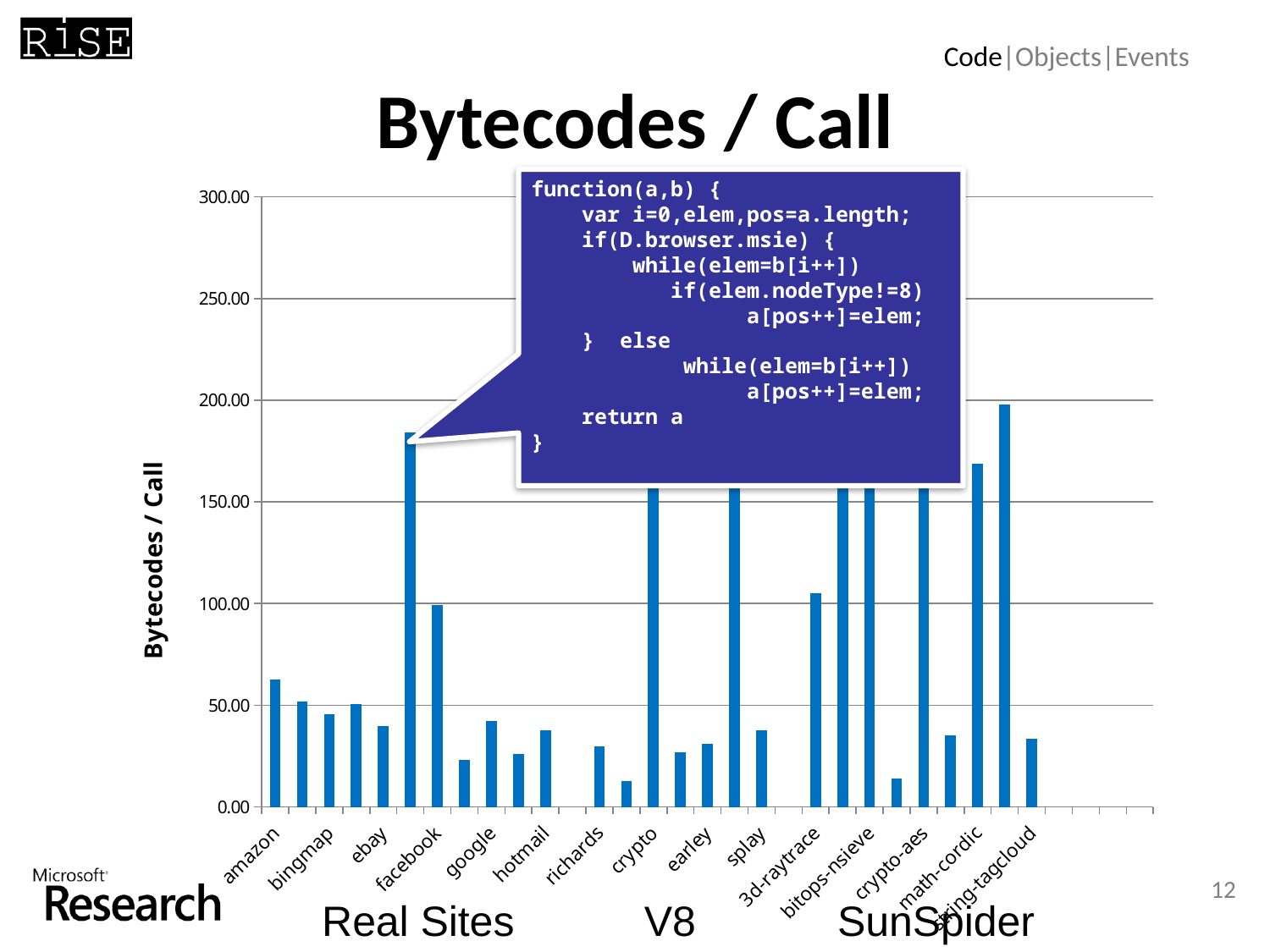
Which has the larger value, math-cordic or string-tagcloud? math-cordic What is the title of the chart? Bytecodes / Call Is the value for math-cordic greater or less than 150.00? greater Is the value for string-tagcloud greater or less than 50.00? less What kind of chart is shown on the slide? bar chart How many category labels are printed along the x axis of the chart? 15 Is the value for hotmail greater or less than 50.00? less What are the three group labels shown beneath the x axis of the chart? Real Sites, V8, SunSpider Which has the larger value, amazon or google? amazon